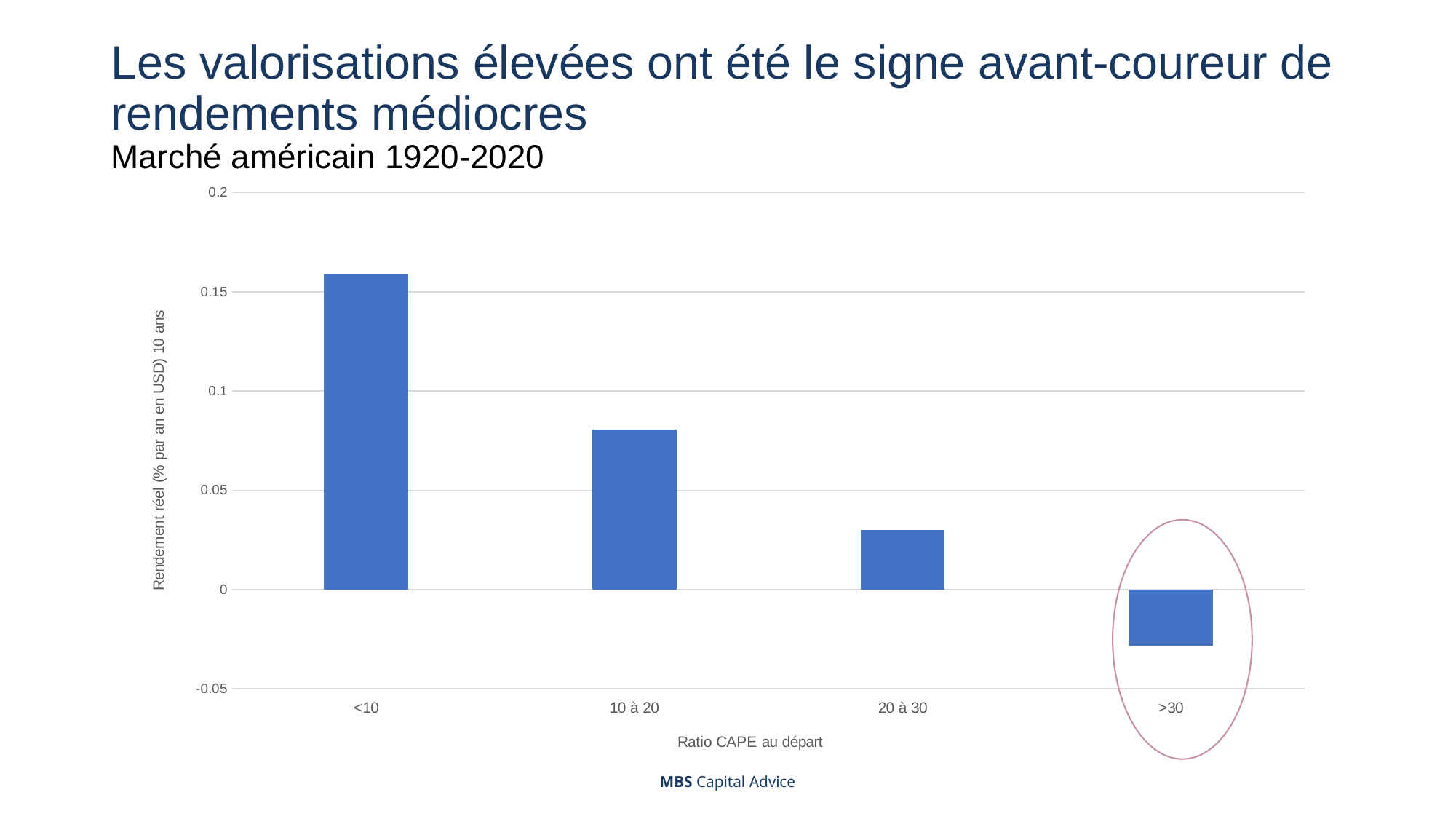
Which category has the lowest value? >30 How many categories are shown on the x axis of the chart? 4 Which category has the highest value? <10 What kind of chart is shown on the slide? bar chart Is the value for <10 greater or less than 0.15? greater Which category's bar is circled on the chart? >30 Which is larger, the value for 10 à 20 or the value for 20 à 30? 10 à 20 What is the title of the x axis of the chart? Ratio CAPE au départ Is the value for 20 à 30 greater or less than 0.05? less Do the values rise or fall as the CAPE ratio increases along the x axis? fall Is the value for 10 à 20 greater or less than 0.1? less